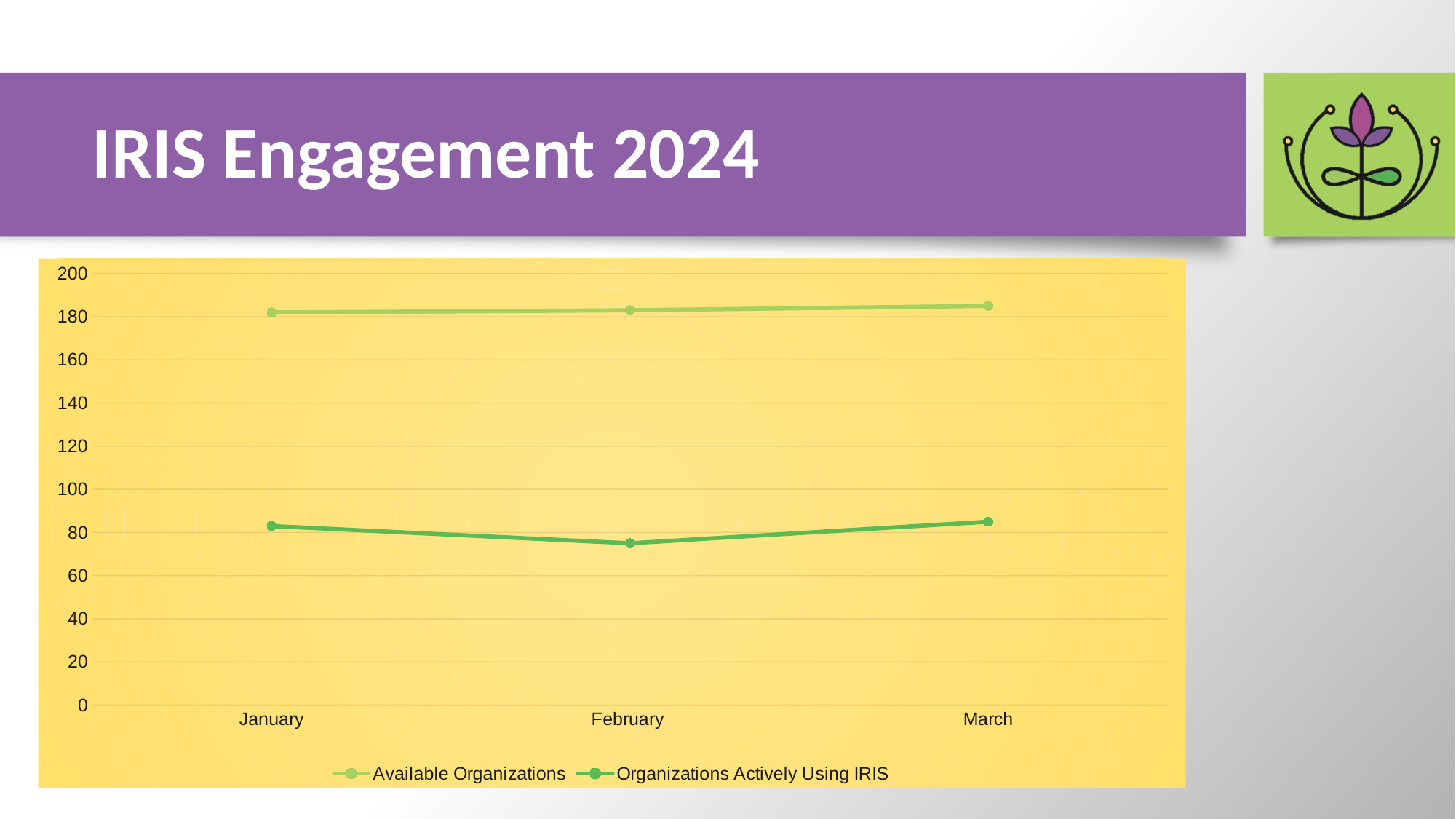
Is the value for Available Organizations in January greater or less than 160? greater How many months are plotted along the x axis? 3 How many series does the legend list? 2 Does the value for Organizations Actively Using IRIS rise or fall from January to February? fall Is the value for Organizations Actively Using IRIS in February greater or less than 80? less Does the value for Organizations Actively Using IRIS rise or fall from February to March? rise Which series has the higher value in February, Available Organizations or Organizations Actively Using IRIS? Available Organizations In which month is the value for Organizations Actively Using IRIS lowest? February Is the value for Available Organizations in March greater or less than 200? less What is the title of the slide containing the chart? IRIS Engagement 2024 What kind of chart is shown on the slide? line chart